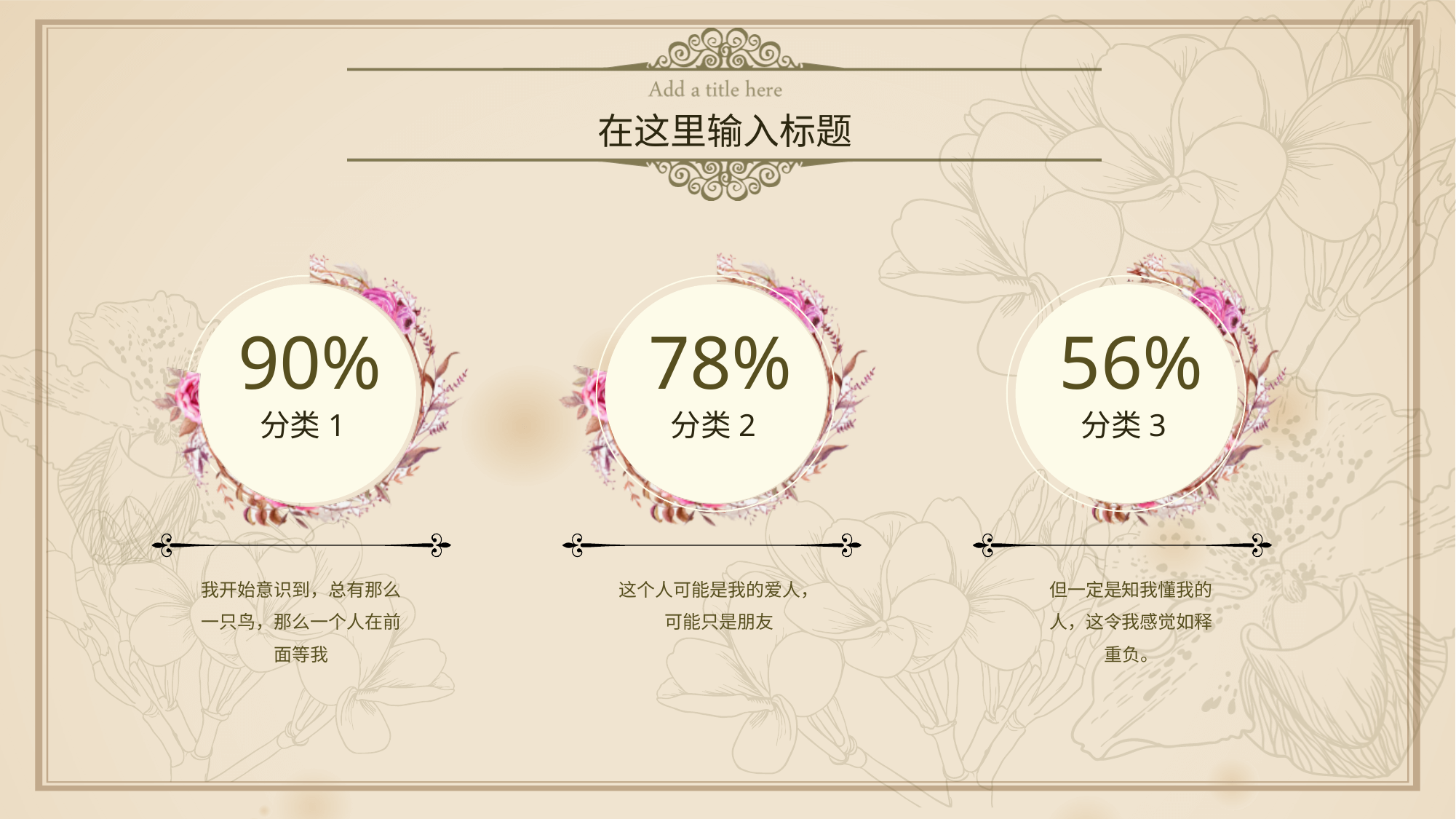
What is the difference between the values for 分类 2 and 分类 3? 22% Which category has the lowest percentage? 分类 3 What is the value shown for 分类 3? 56% Which is larger, the value for 分类 2 or the value for 分类 3? 分类 2 What is the title of the slide? 在这里输入标题 Which category has the highest percentage? 分类 1 Do the percentage values rise or fall from 分类 1 to 分类 3? fall What is the value shown for 分类 1? 90% What is the value shown for 分类 2? 78% What is the difference between the values for 分类 1 and 分类 2? 12% How many categories are shown on the slide? 3 What is the difference between the values for 分类 1 and 分类 3? 34%